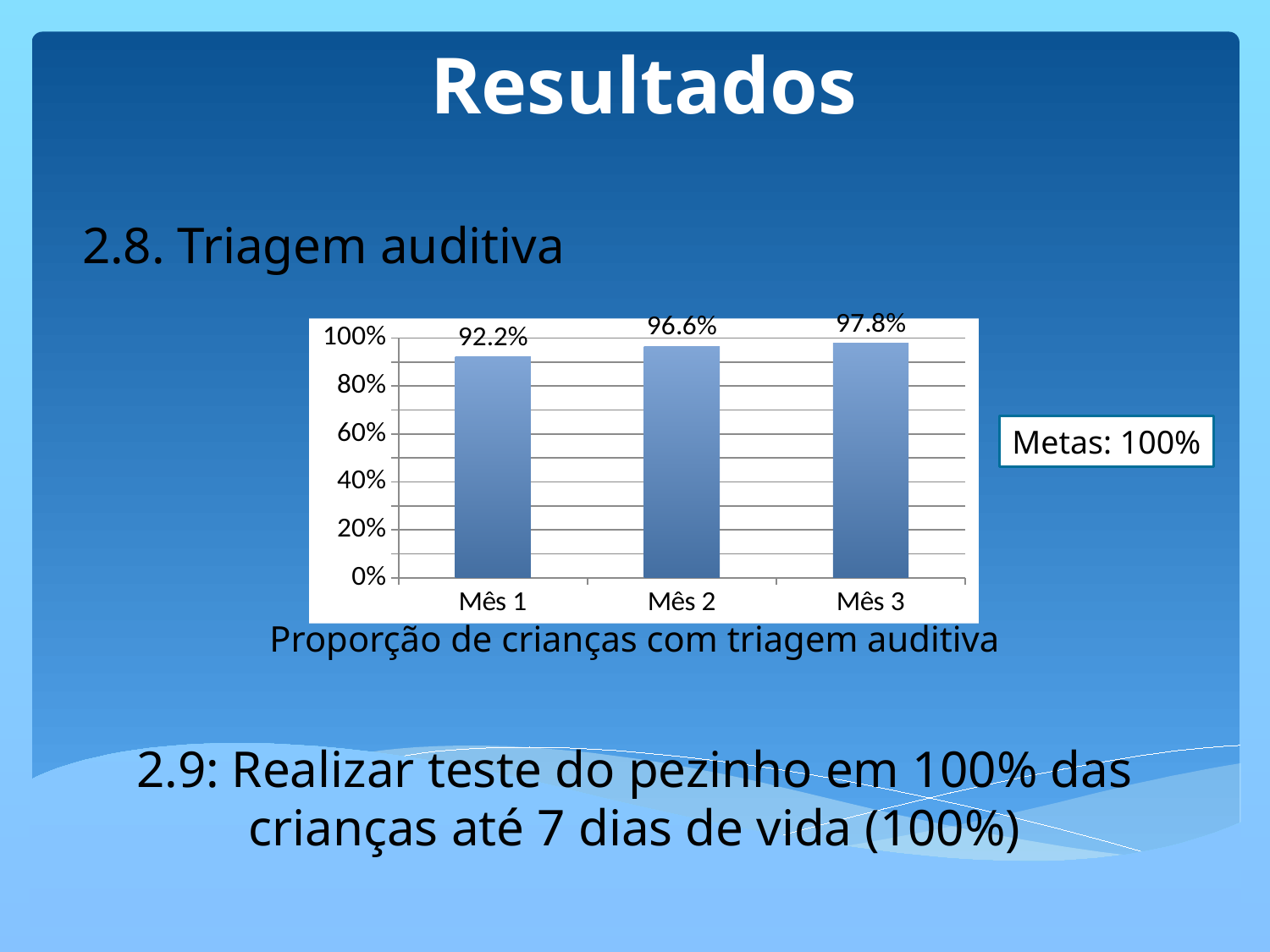
Do the values rise or fall from Mês 1 to Mês 3? rise Which month has the highest value? Mês 3 What is the value for Mês 1? 92.2% Which month has the lowest value? Mês 1 What is the value for Mês 3? 97.8% What kind of chart is shown? bar chart How many months are shown on the chart? 3 Is the value for Mês 1 greater or less than 80%? greater Which is larger, the value for Mês 1 or the value for Mês 2? Mês 2 What is the value for Mês 2? 96.6% What is the difference between the values for Mês 2 and Mês 1? 4.4% What is the difference between the values for Mês 3 and Mês 1? 5.6%